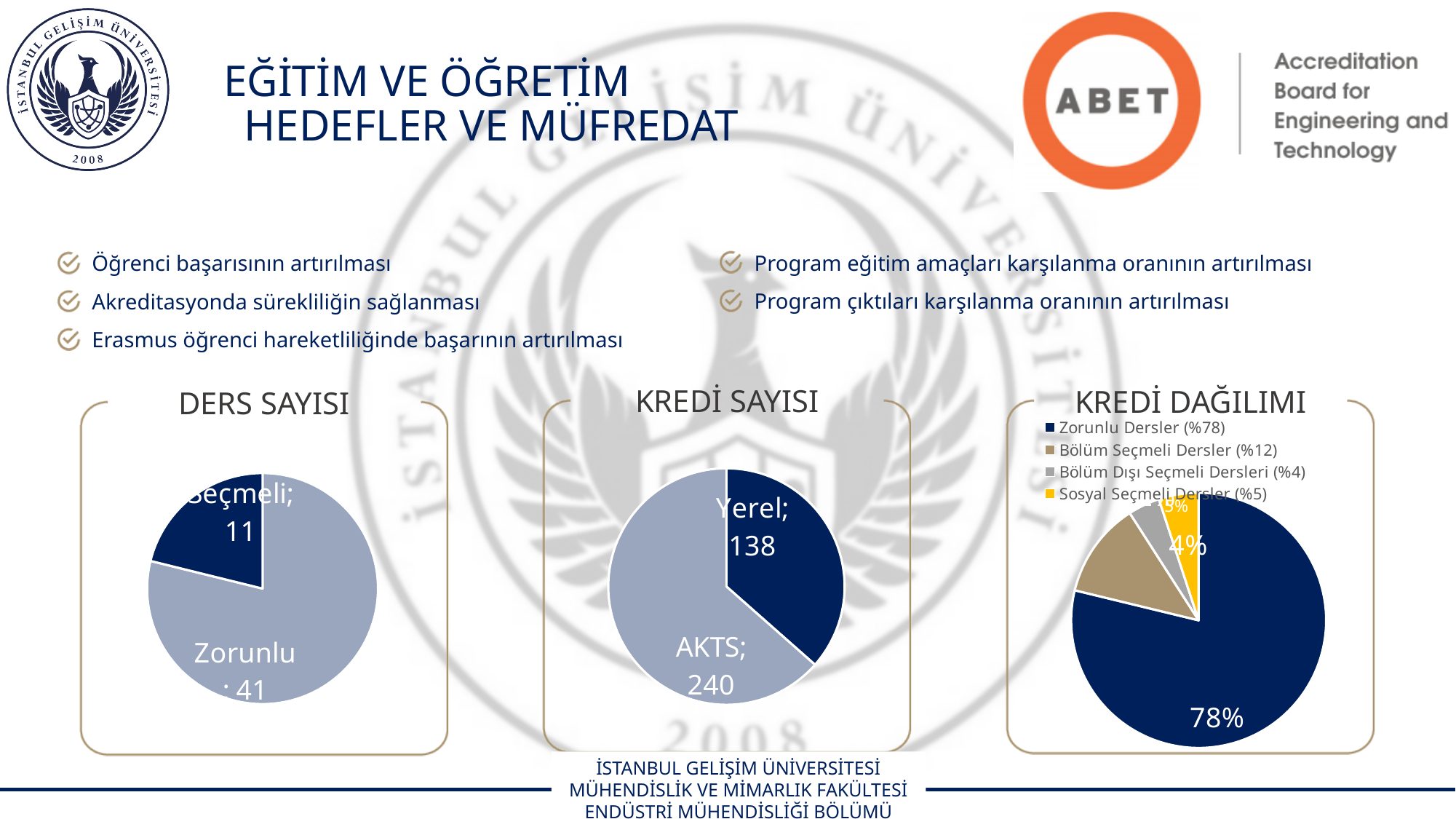
In the DERS SAYISI chart, what is the value for Zorunlu? 41 In the DERS SAYISI chart, which category is larger, Zorunlu or Seçmeli? Zorunlu In the KREDİ SAYISI chart, what is the difference between AKTS and Yerel? 102 In the KREDİ DAĞILIMI chart, what share do Zorunlu Dersler have? 78% In the DERS SAYISI chart, what is the difference between Zorunlu and Seçmeli? 30 In the DERS SAYISI chart, what is the value for Seçmeli? 11 In the KREDİ SAYISI chart, what is the value for Yerel? 138 In the KREDİ SAYISI chart, which slice is the largest? AKTS In the KREDİ DAĞILIMI chart, which category has the smallest share? Bölüm Dışı Seçmeli Dersleri In the KREDİ DAĞILIMI chart, how many categories does the legend list? 4 In the KREDİ SAYISI chart, what is the value for AKTS? 240 What kind of chart is the DERS SAYISI chart? Pie chart